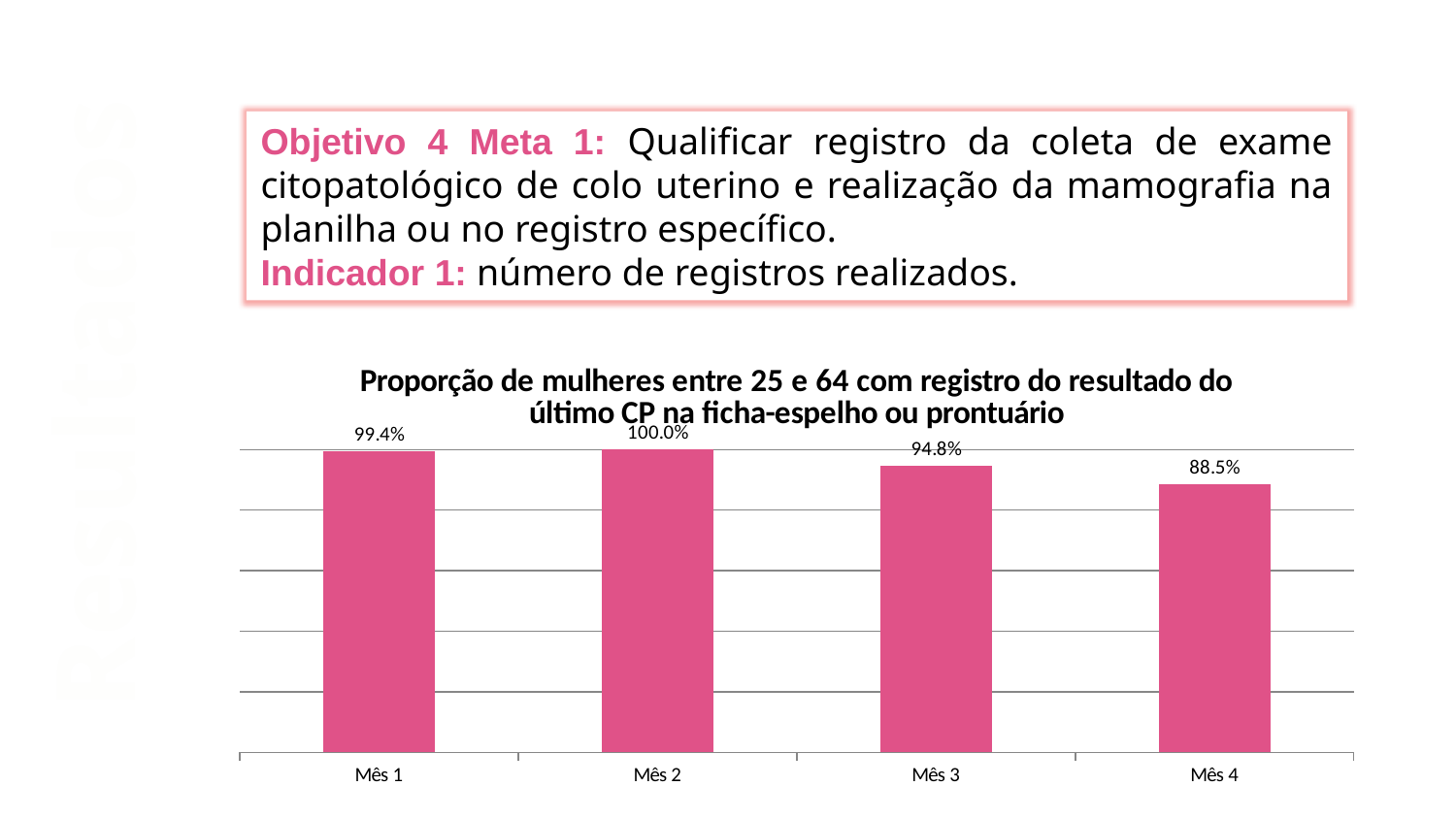
How many months are shown on the x axis? 4 What is the value for Mês 3? 94.8% What is the title of the chart? Proporção de mulheres entre 25 e 64 com registro do resultado do último CP na ficha-espelho ou prontuário What is the difference between the values for Mês 1 and Mês 3? 4.6% What kind of chart is shown on the slide? Bar chart What is the value for Mês 1? 99.4% What is the difference between the values for Mês 2 and Mês 4? 11.5% Which month has the highest value? Mês 2 Which month has the lowest value? Mês 4 What is the value for Mês 2? 100.0% What is the value for Mês 4? 88.5% Which is larger, the value for Mês 3 or the value for Mês 4? Mês 3